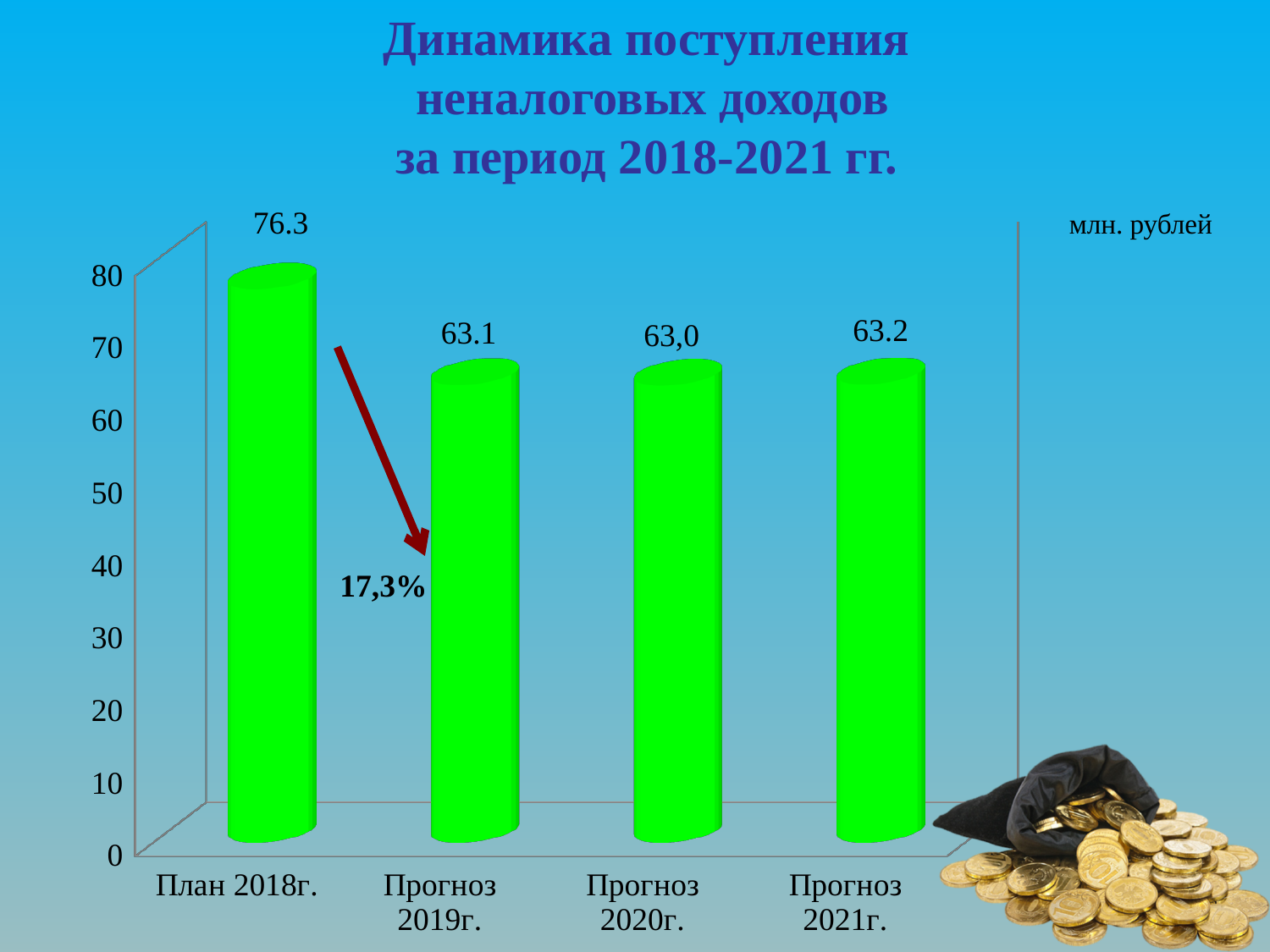
Is the value for Прогноз 2019г. greater or less than 70? less Which is larger, the value for План 2018г. or the value for Прогноз 2021г.? План 2018г. What is the value for Прогноз 2020г.? 63,0 What is the value for План 2018г.? 76.3 What is the difference between the values for План 2018г. and Прогноз 2019г.? 13.2 What is the value for Прогноз 2021г.? 63.2 What kind of chart is shown on the slide? bar chart Which category has the lowest value according to the data labels? Прогноз 2020г. What is the value for Прогноз 2019г.? 63.1 How many categories are shown on the chart? 4 What unit of measurement is indicated on the chart? млн. рублей Which category has the highest value? План 2018г.